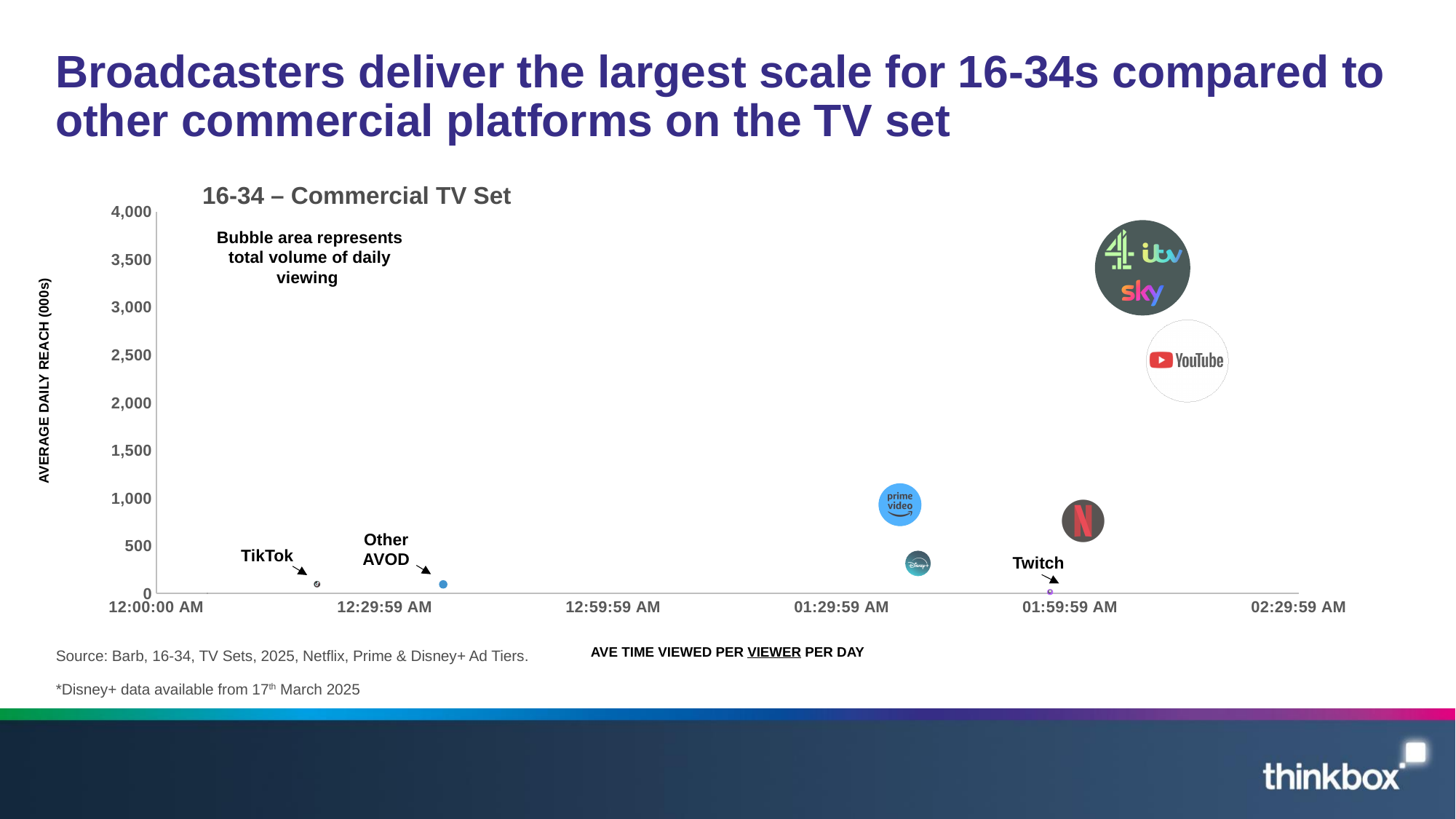
Is the average daily reach for the broadcasters bubble (4, ITV, Sky) greater or less than 3,000? greater Is the average daily reach for YouTube greater or less than 2,000? greater Which platform has the lowest average daily reach in the chart? Twitch What kind of chart is shown on the slide? Bubble chart Which platform has the highest average daily reach in the chart? Broadcasters (4, ITV, Sky) Is the average daily reach for Netflix greater or less than 1,000? less What does the bubble area represent in the chart? Total volume of daily viewing What is the title of the chart? 16-34 – Commercial TV Set How many platform bubbles are plotted in the chart? 8 Which has a higher average daily reach, Netflix or Disney+? Netflix